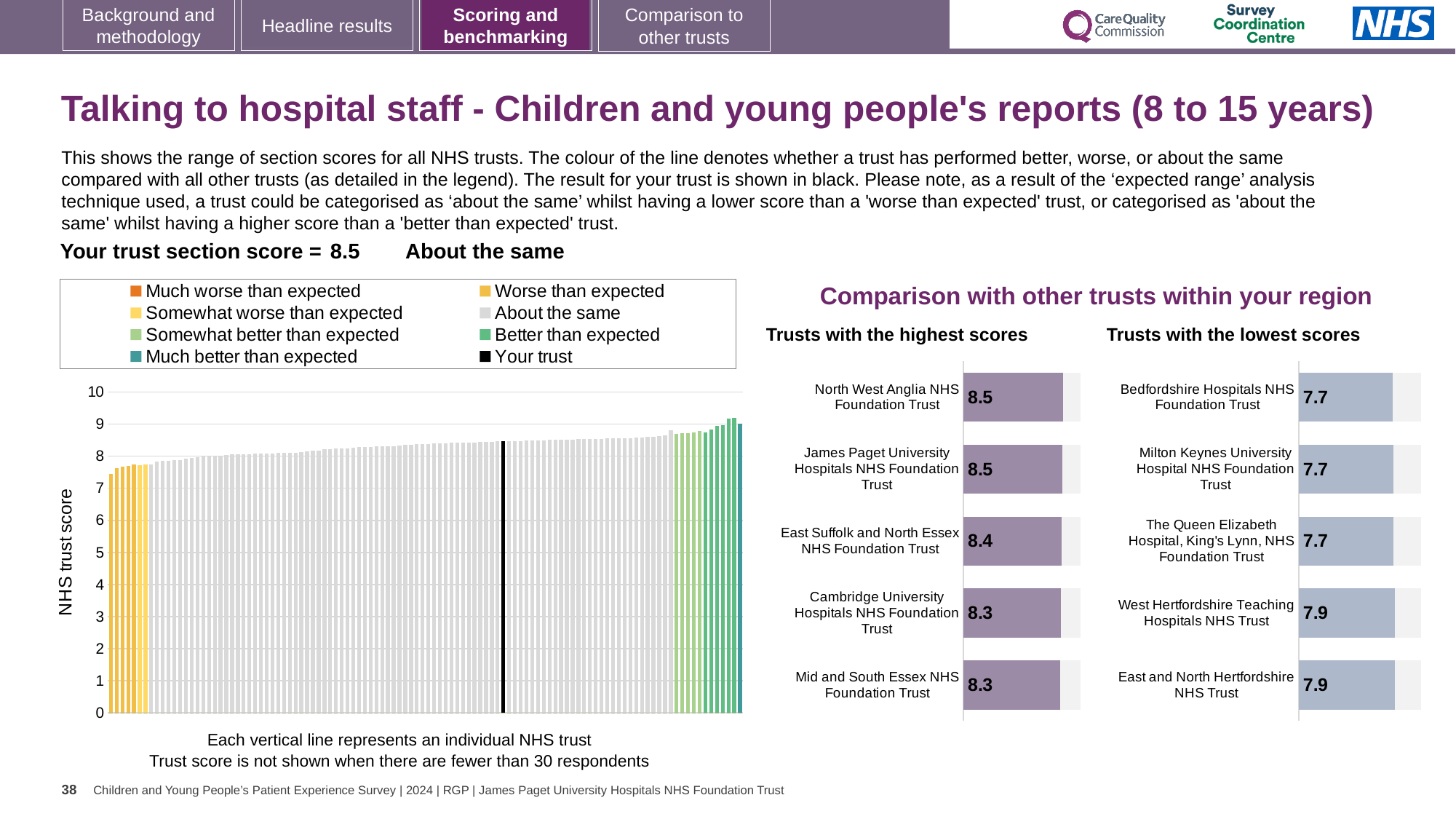
In the 'Trusts with the lowest scores' chart, what is the score for Bedfordshire Hospitals NHS Foundation Trust? 7.7 In the 'Trusts with the highest scores' chart, what is the score for East Suffolk and North Essex NHS Foundation Trust? 8.4 In the large 'NHS trust score' chart on the left, is the value of the black 'Your trust' bar greater or less than 8? greater In the 'Trusts with the lowest scores' chart, what is the difference between the score for West Hertfordshire Teaching Hospitals NHS Trust and the score for The Queen Elizabeth Hospital, King's Lynn, NHS Foundation Trust? 0.2 In the 'Trusts with the highest scores' chart, how many trusts are listed? 5 In the 'Trusts with the highest scores' chart, what is the score for Cambridge University Hospitals NHS Foundation Trust? 8.3 In the 'Trusts with the highest scores' chart, what is the difference between the score for North West Anglia NHS Foundation Trust and the score for Mid and South Essex NHS Foundation Trust? 0.2 In the 'Trusts with the lowest scores' chart, which is larger: the score for East and North Hertfordshire NHS Trust or the score for Milton Keynes University Hospital NHS Foundation Trust? East and North Hertfordshire NHS Trust In the 'Trusts with the lowest scores' chart, what is the score for West Hertfordshire Teaching Hospitals NHS Trust? 7.9 In the large 'NHS trust score' chart on the left, do the bar heights rise or fall from left to right? rise What kind of chart is the large 'NHS trust score' chart on the left of the slide? bar chart How many entries does the legend above the large 'NHS trust score' chart list? 8